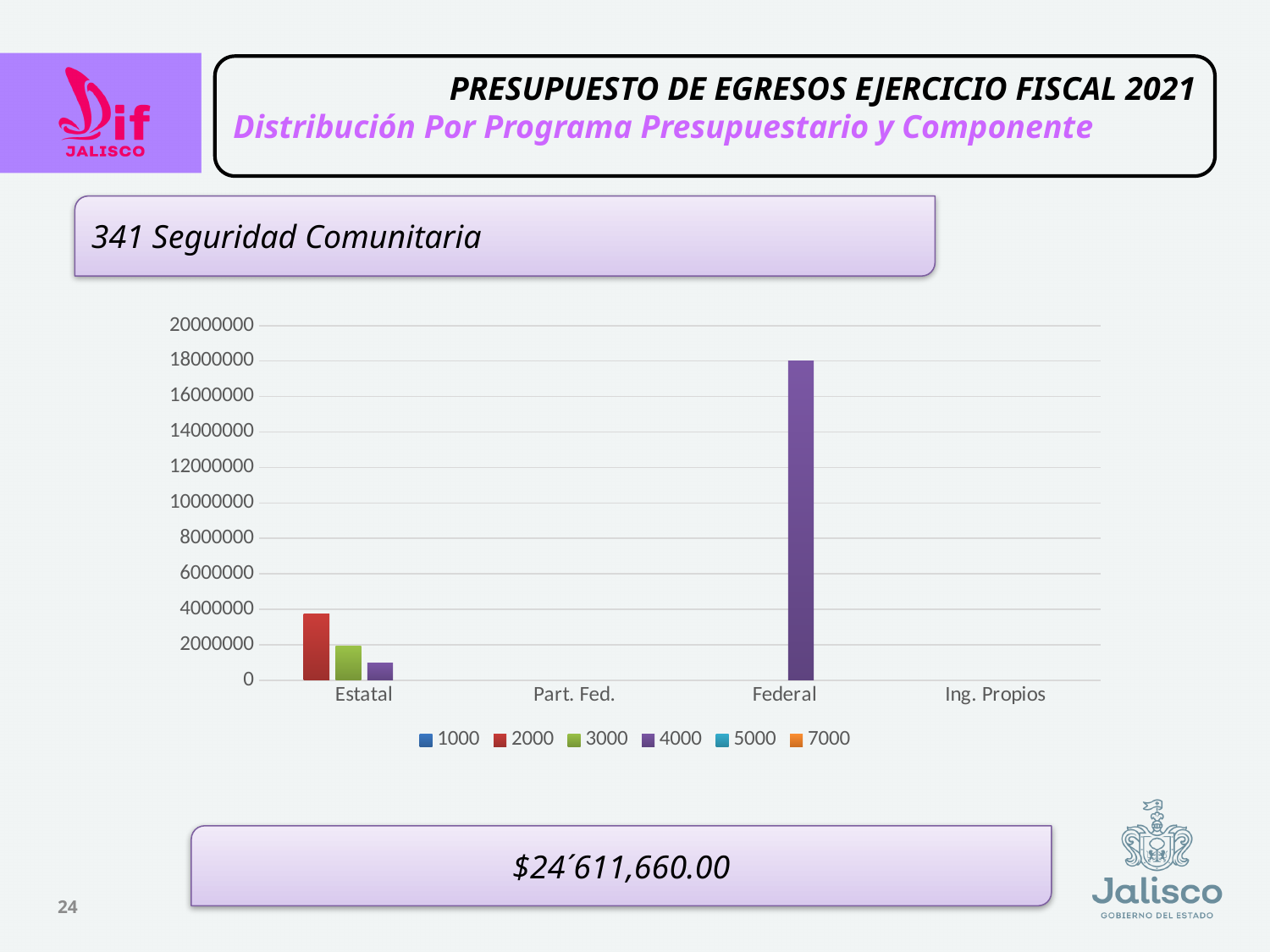
How many categories are shown on the x axis of the chart? 4 Is the value of the 4000 series for Estatal greater or less than 2000000? less Is the value of the 2000 series for Estatal greater or less than 2000000? greater Which is larger for Estatal: the 2000 series or the 3000 series? 2000 Is the value of the 3000 series for Estatal greater or less than 4000000? less What kind of chart is shown on the slide? bar chart What is the title shown above the chart? 341 Seguridad Comunitaria Which category has the tallest bar in the chart? Federal Which series is shown in red in the legend? 2000 Which is larger in the 4000 series: Estatal or Federal? Federal How many series does the chart's legend list? 6